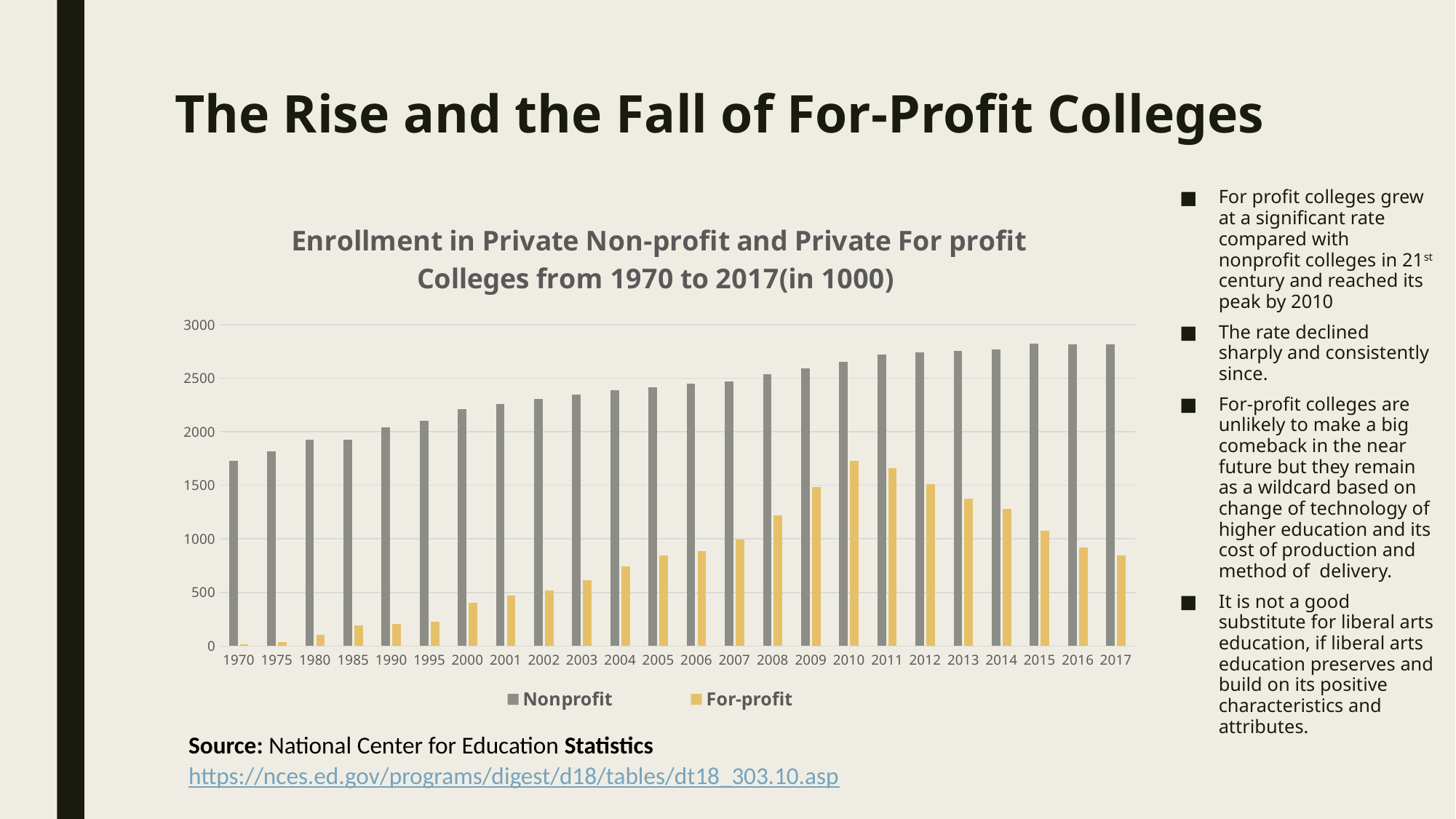
How many series does the legend list? 2 Does the Nonprofit enrollment generally rise or fall from 1970 to 2017? Rise What kind of chart is shown on the slide? Bar chart Which is larger, the For-profit value for 2010 or the For-profit value for 2017? 2010 How many years are shown on the x axis? 24 In which year is the For-profit enrollment highest? 2010 In which year is the For-profit enrollment lowest? 1970 Is the For-profit value for 2010 greater or less than 1500? greater What are the two series named in the legend? Nonprofit and For-profit Is the For-profit value for 2017 greater or less than 1000? less Is the Nonprofit value for 2017 greater or less than 2500? greater In which year is the Nonprofit enrollment lowest? 1970